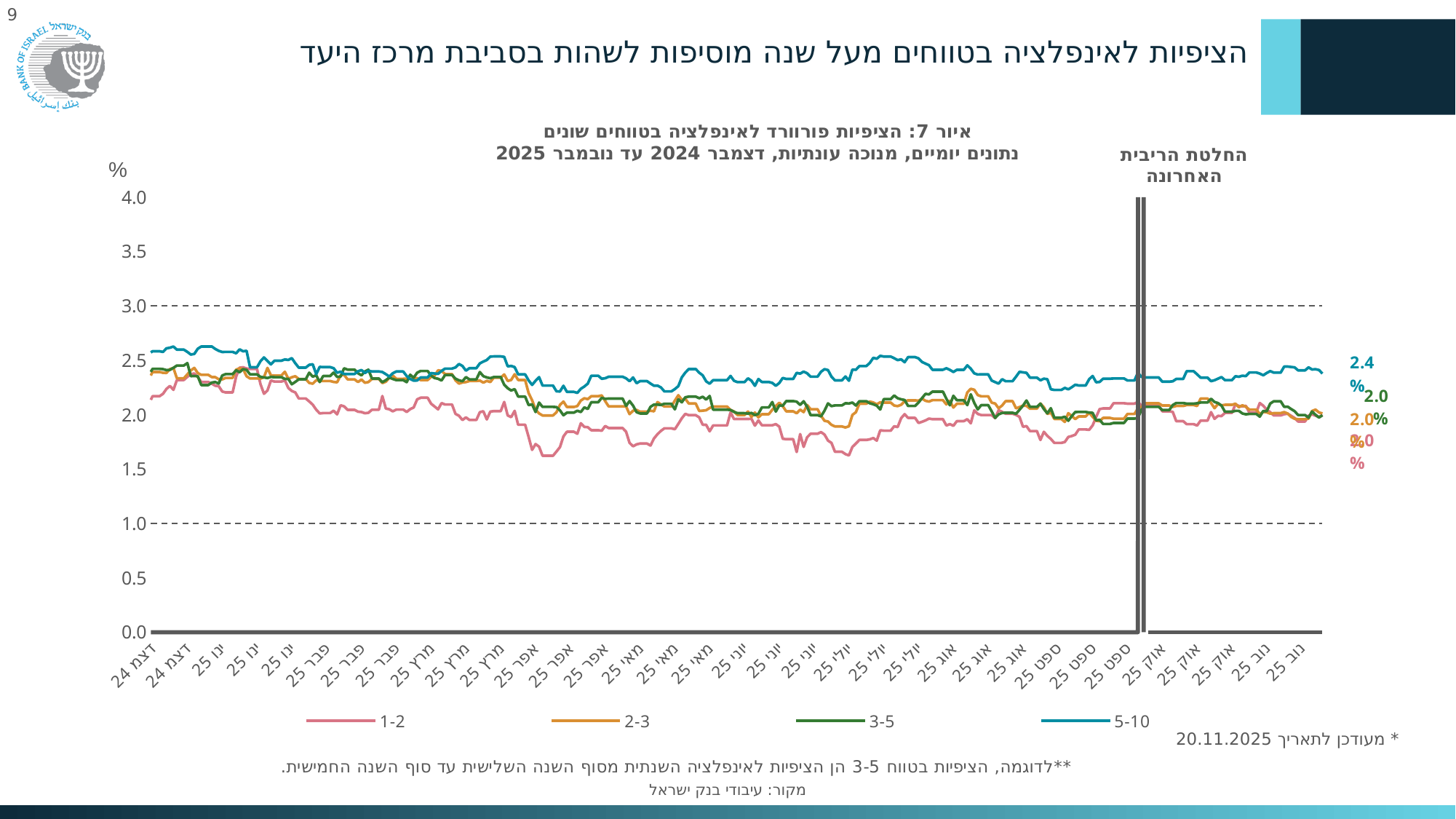
How many series does the legend list? 4 At the right end of the chart, which is larger: the 5-10 series or the 1-2 series? 5-10 What does the label above the vertical line near the right of the chart say? החלטת הריבית האחרונה What are the series names listed in the legend? 1-2, 2-3, 3-5, 5-10 Is the highest value reached by the 5-10 series greater or less than 3.0? less Does the 1-2 series rise or fall from December 2024 to April 2025? fall What is the latest value shown for the 3-5 series at the right end of the chart? 2.0% Which series has the lowest value in April 2025 (אפר 25)? 1-2 What kind of chart is shown on the slide? line chart Which series has the highest value at the right end of the chart? 5-10 Is the value of the 1-2 series in April 2025 (אפר 25) greater or less than 2.0? less What is the latest value shown for the 5-10 series at the right end of the chart? 2.4%